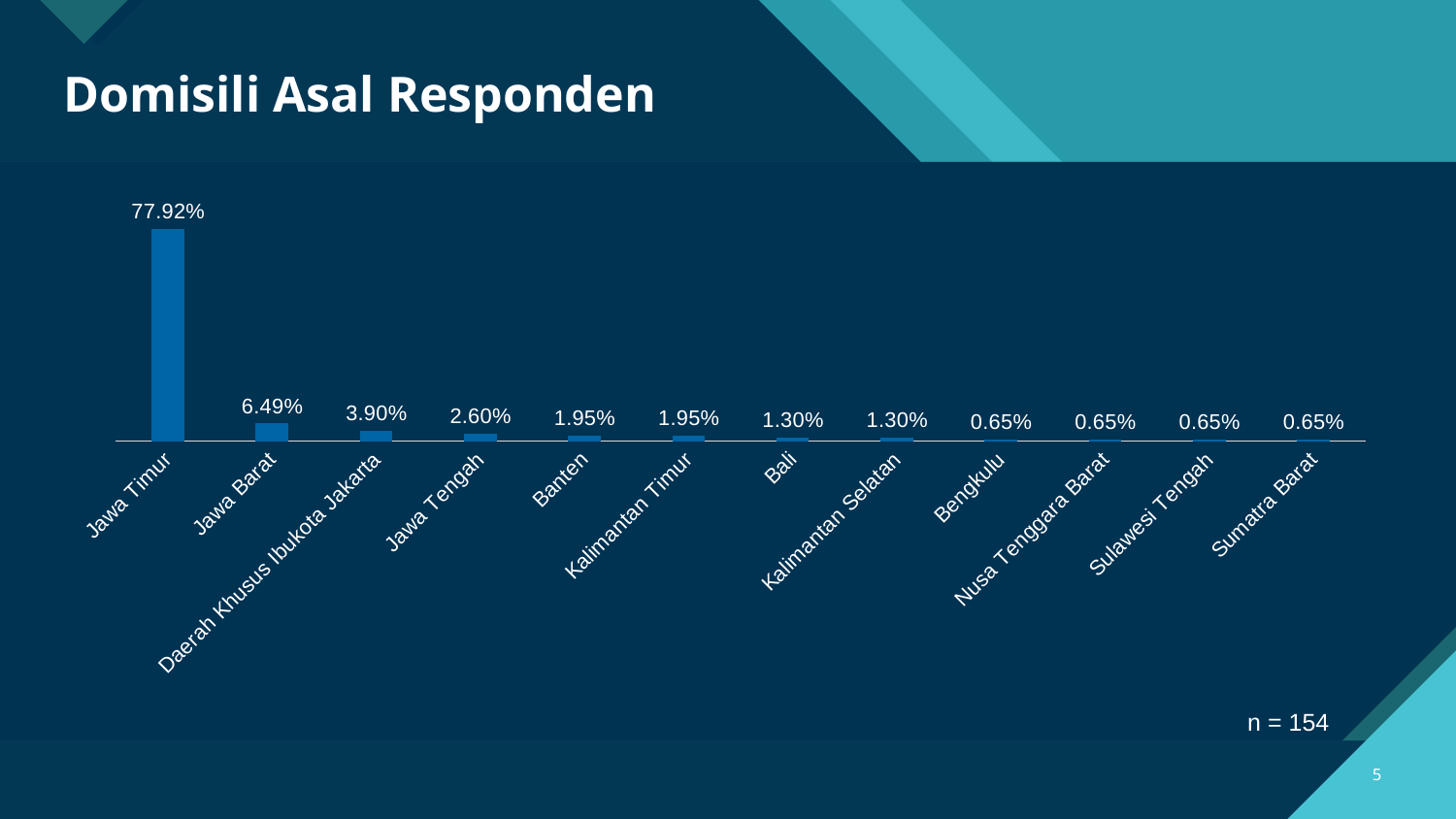
What is the title of the slide containing the chart? Domisili Asal Responden How many categories are shown in the chart? 12 What is the value for Jawa Timur? 77.92% What kind of chart is shown on the slide? Bar chart What is the difference between the values for Jawa Timur and Jawa Barat? 71.43% What is the difference between the values for Jawa Barat and Daerah Khusus Ibukota Jakarta? 2.59% What is the value for Daerah Khusus Ibukota Jakarta? 3.90% Which category has the highest value? Jawa Timur Which is larger, the value for Jawa Tengah or the value for Banten? Jawa Tengah What is the value for Bali? 1.30% What is the value for Jawa Barat? 6.49% What is the value for Jawa Tengah? 2.60%